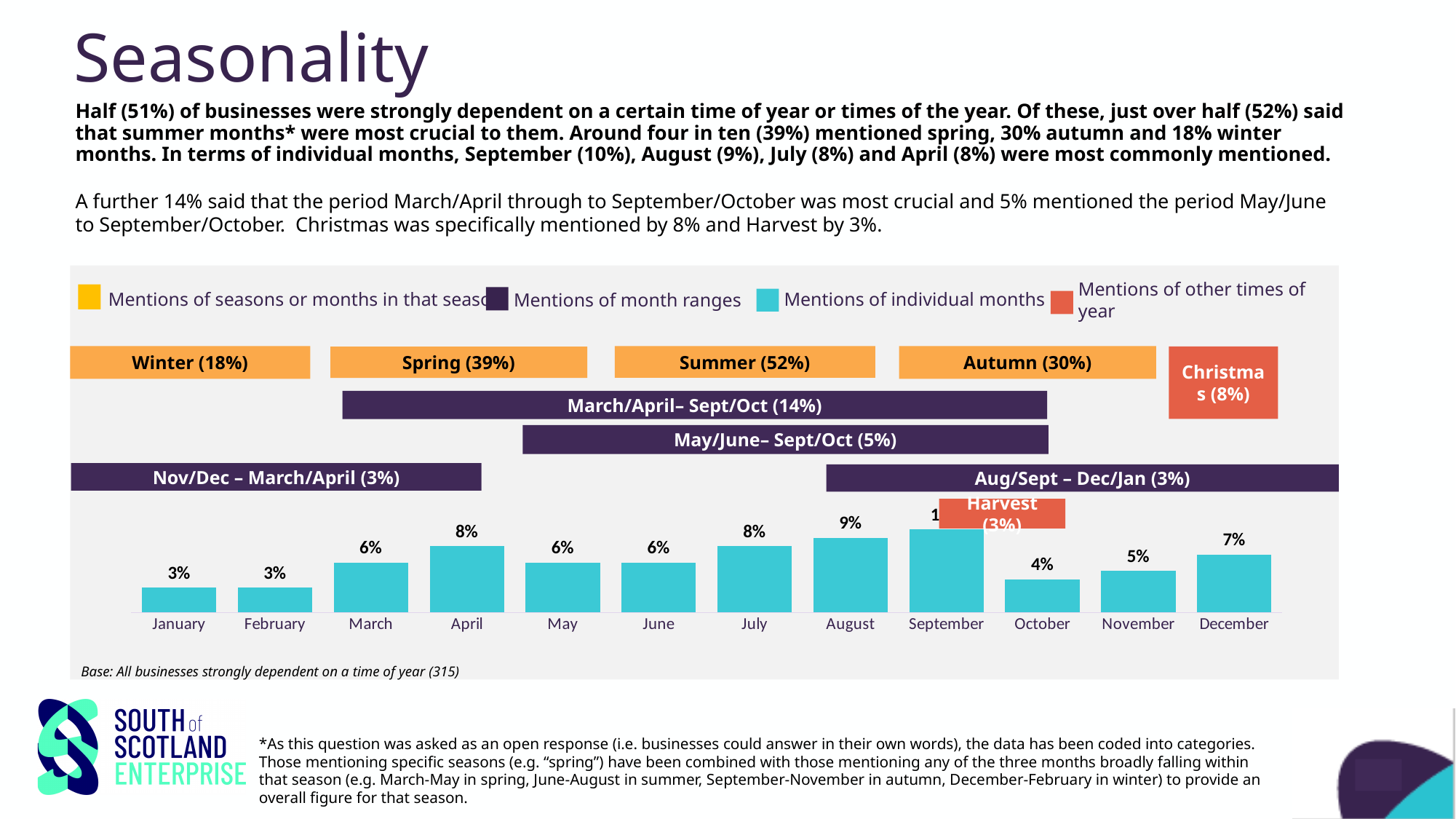
What is the difference between the percentages for August and February? 6% Which has a higher value, December or November? December What percentage is shown for the March/April– Sept/Oct month range? 14% What colour are the bars for mentions of individual months? Teal What type of chart is used to show mentions of individual months? Bar chart What is the value shown for October in the individual months bar chart? 4% What percentage is shown for the Summer season bar? 52% How many individual months are shown along the x axis of the bar chart? 12 How many categories does the legend list? 4 What percentage of businesses mentioned April as an individual month? 8% Which individual month has the tallest bar in the chart? September Which season has the lowest percentage among the four season bars? Winter (18%)